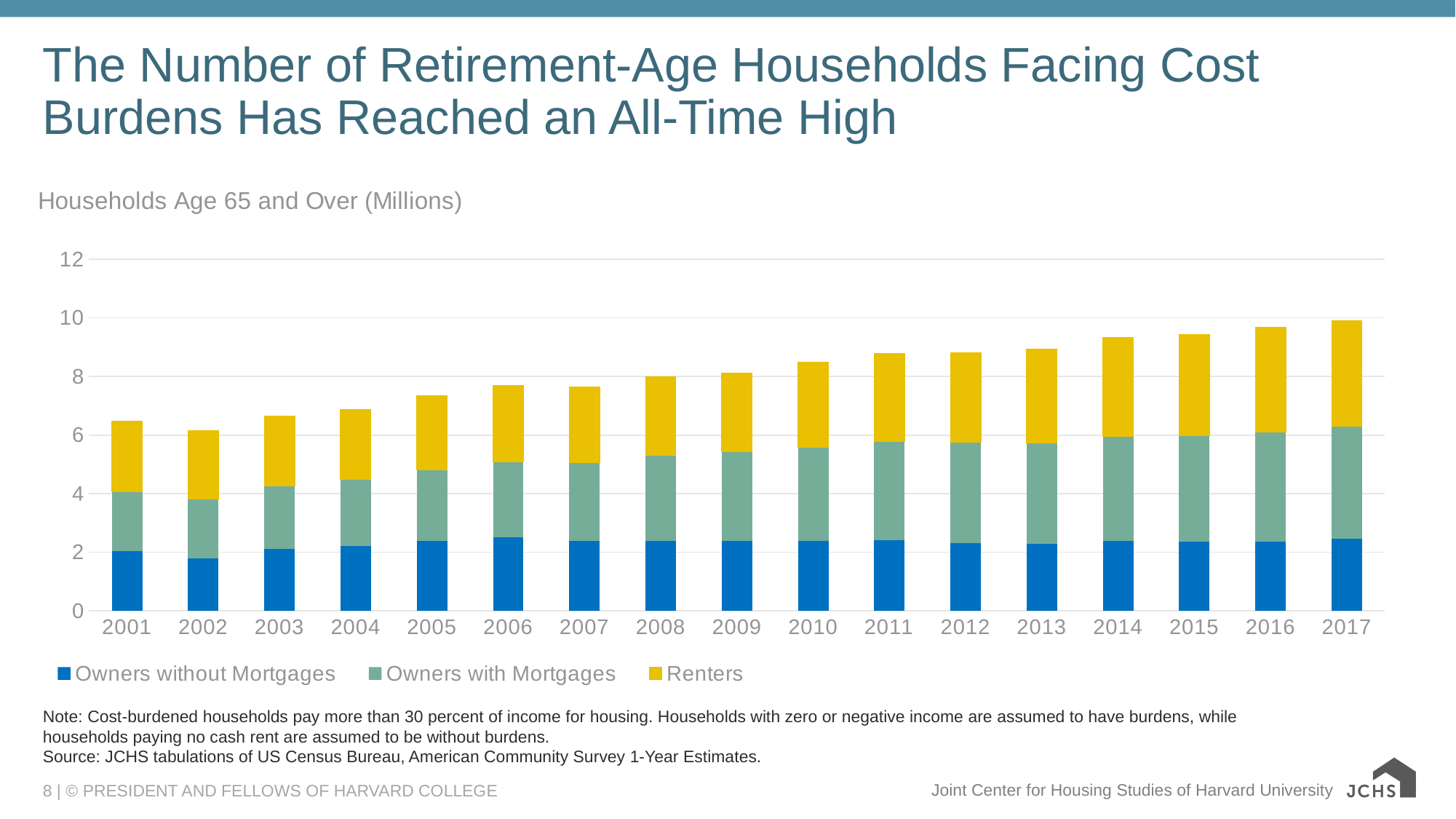
Do the total bar heights generally rise or fall from 2001 to 2017? Rise Is the total value for 2017 greater or less than 8? greater Is the total value for 2001 greater or less than 8? less What kind of chart is shown on the slide? Stacked bar chart Which year has the tallest total bar in the chart? 2017 Which series is shown in yellow in the chart? Renters Which year has a larger total bar, 2002 or 2003? 2003 How many series does the chart's legend list? 3 Which year has a larger total bar, 2001 or 2017? 2017 How many years are shown along the x axis of the chart? 17 Is the total value for 2010 greater or less than 8? greater Which year has the shortest total bar in the chart? 2002